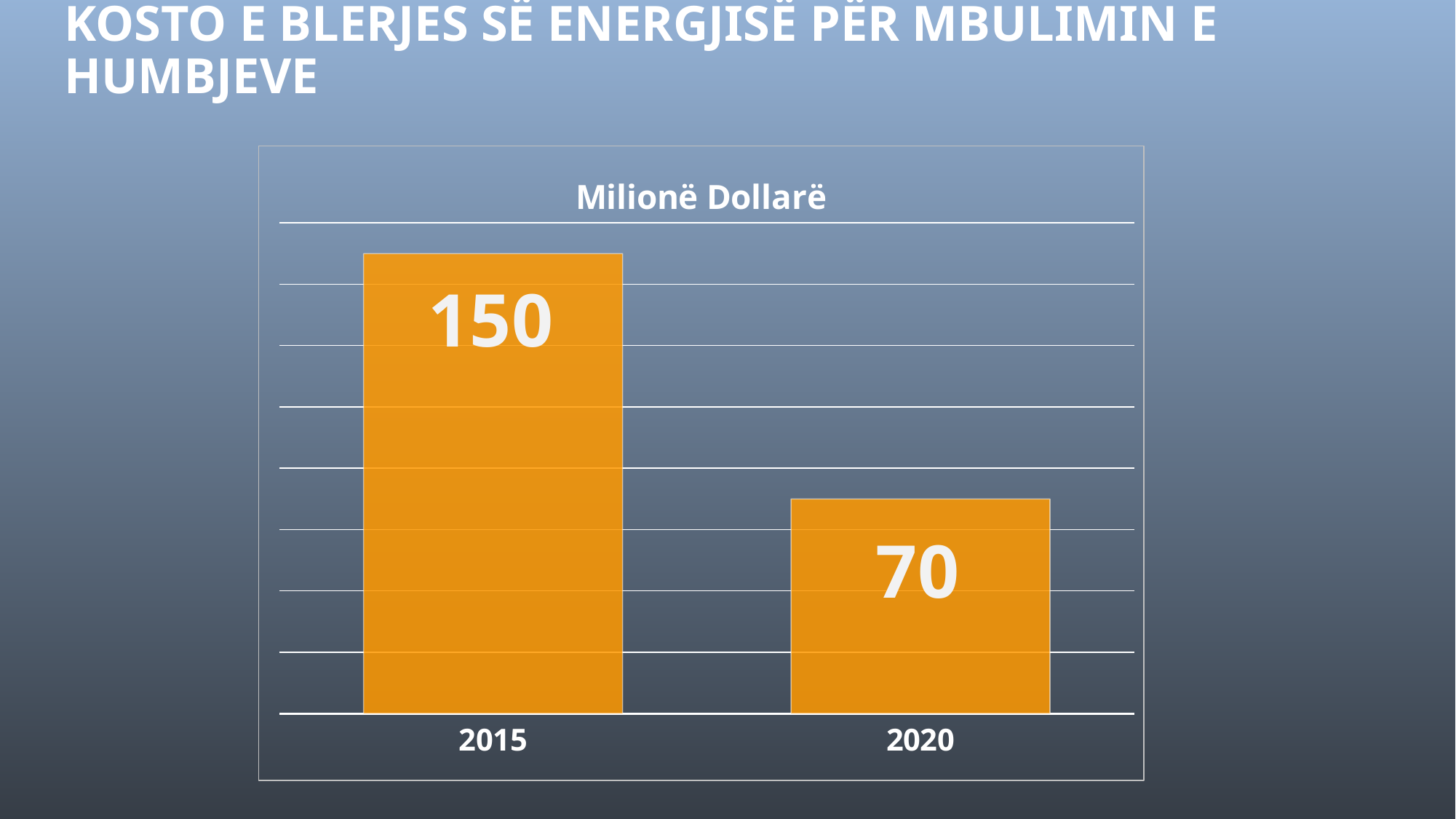
What is the value for 2020? 70 Which is larger, the value for 2015 or the value for 2020? 2015 What is the difference between the values for 2015 and 2020? 80 How many bars are shown in the chart? 2 What kind of chart is shown on the slide? Bar chart What is the title of the chart? Milionë Dollarë What is the value for 2015? 150 Do the values rise or fall from 2015 to 2020? Fall Which year has the lowest value? 2020 Which year has the highest value? 2015 What colour are the bars in the chart? Orange